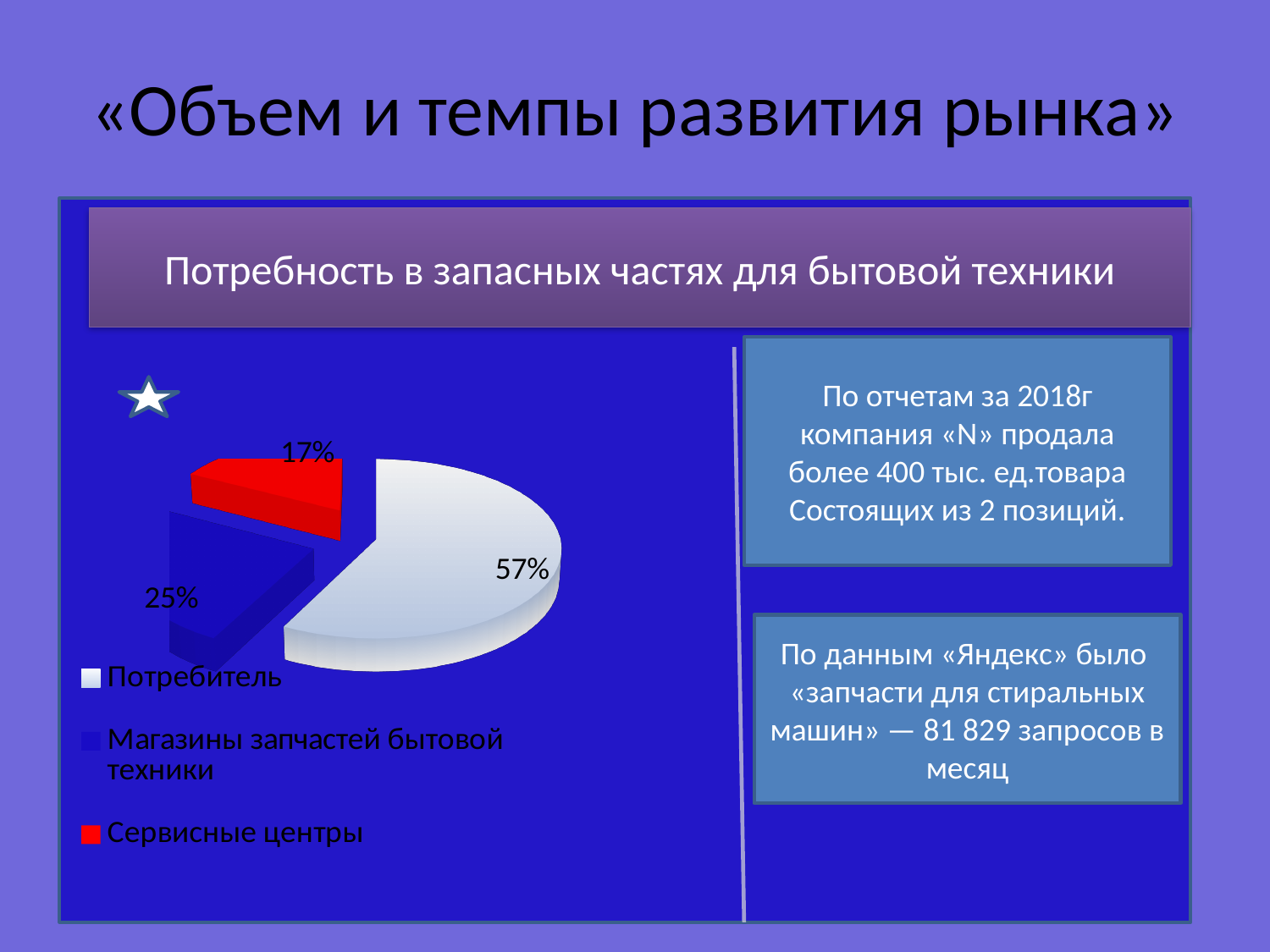
What share of the pie does the "Сервисные центры" slice have? 17% What share of the pie does the "Потребитель" slice have? 57% How many slices does the pie chart have? 3 What colour is the "Сервисные центры" slice in the pie chart? Red What type of chart is shown on the slide? Pie chart Which category has the smallest share of the pie? Сервисные центры What is the difference in percentage points between the "Потребитель" and "Сервисные центры" slices? 40 What is the title of the chart? Потребность в запасных частях для бытовой техники Which category has the largest share of the pie? Потребитель What share of the pie does the "Магазины запчастей бытовой техники" slice have? 25% Which is larger: the share for "Магазины запчастей бытовой техники" or the share for "Сервисные центры"? Магазины запчастей бытовой техники What is the difference in percentage points between the "Магазины запчастей бытовой техники" and "Сервисные центры" slices? 8